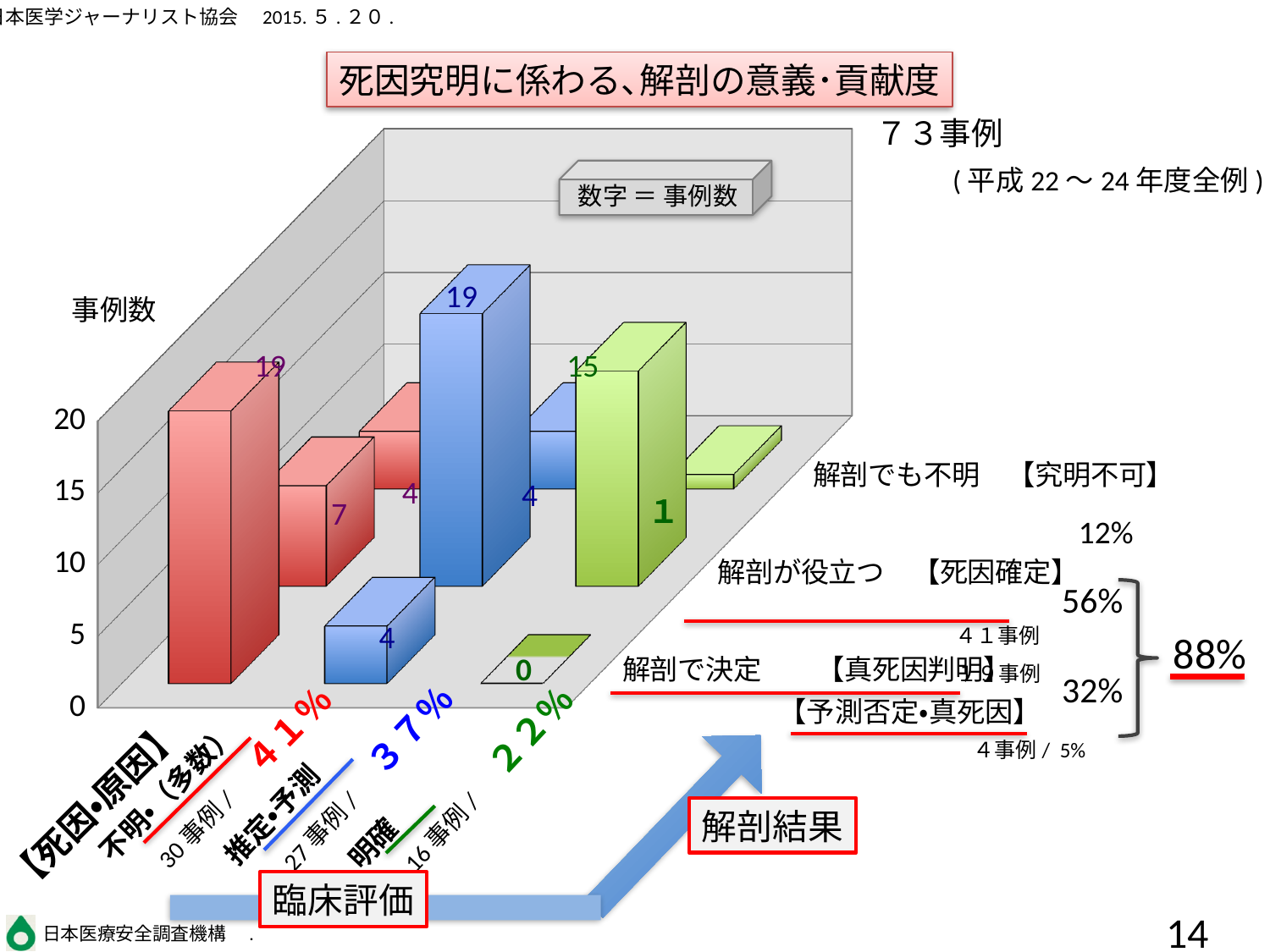
What is the highest value labelled on any bar in the chart? 19 What is the difference in number of cases between the 不明・(多数) category (30) and the 明確 category (16)? 14 How many cases in total does the chart cover, as stated on the slide? 73事例 What percentage is shown for 解剖が役立つ【死因確定】? 56% What percentage is shown for 解剖でも不明【究明不可】? 12% Which clinical evaluation category has the most cases? 不明・(多数) How many categories of clinical evaluation (臨床評価) are shown along the x axis? 3 How many cases are in the 推定・予測 category? 27事例 What is the title of the chart? 死因究明に係わる、解剖の意義・貢献度 What kind of chart is shown on the slide? bar chart What percentage is shown for the 不明・(多数) category? 41% How many cases are in the 明確 category? 16事例